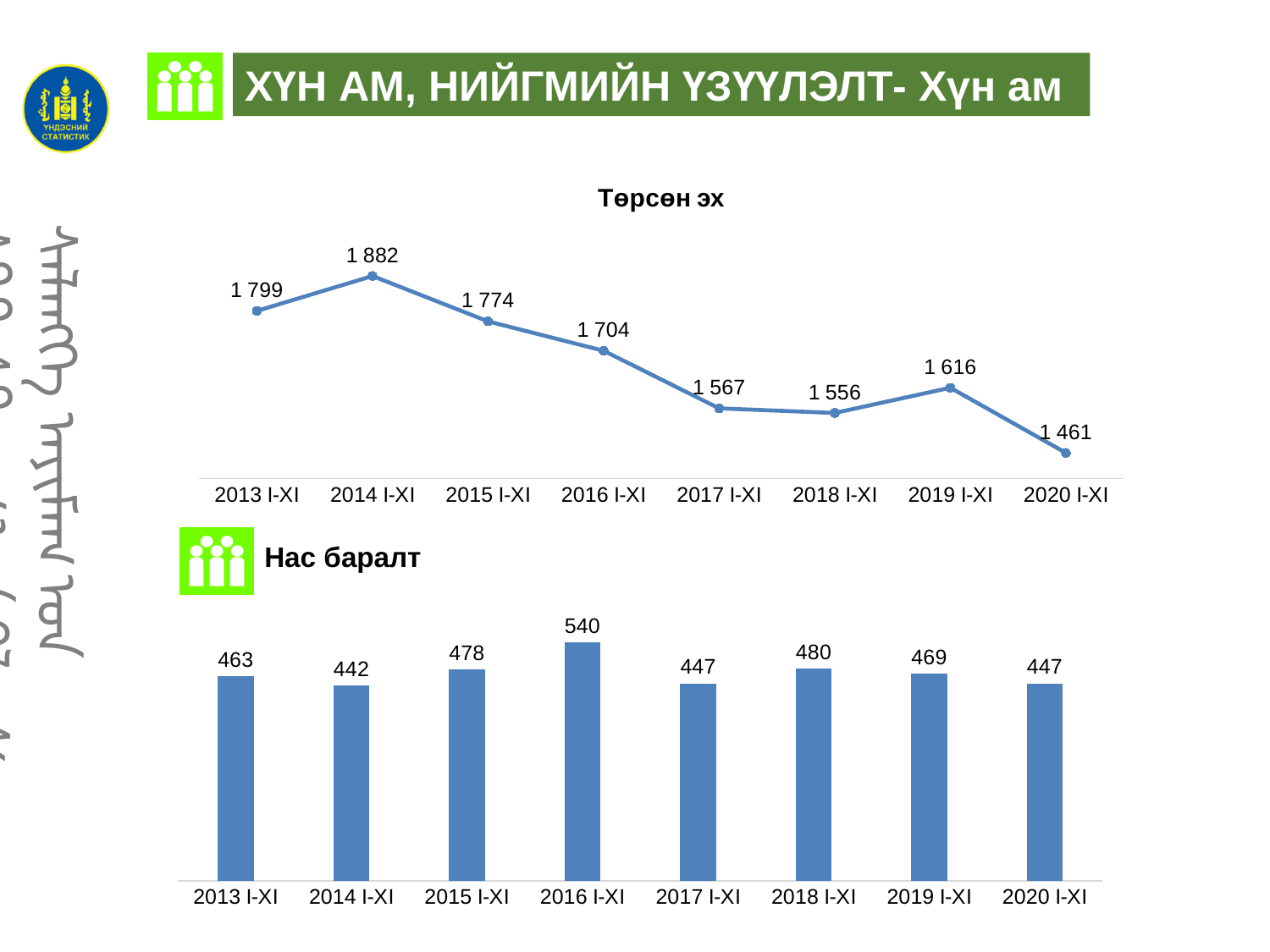
In the 'Төрсөн эх' chart, which period has the lowest value? 2020 I-XI In the 'Нас баралт' chart, what is the difference between the values for 2016 I-XI and 2015 I-XI? 62 In the 'Төрсөн эх' chart, what kind of chart is shown? line chart In the 'Төрсөн эх' chart, is the value for 2019 I-XI larger or smaller than the value for 2018 I-XI? larger In the 'Нас баралт' chart, which period has the lowest value? 2014 I-XI In the 'Нас баралт' chart, how many bars are there? 8 In the 'Нас баралт' chart, what kind of chart is shown? bar chart In the 'Төрсөн эх' chart, what is the value for 2014 I-XI? 1 882 In the 'Төрсөн эх' chart, which period has the highest value? 2014 I-XI In the 'Төрсөн эх' chart, what is the difference between the values for 2013 I-XI and 2020 I-XI? 338 In the 'Төрсөн эх' chart, how many data points are plotted? 8 In the 'Нас баралт' chart, what is the value for 2016 I-XI? 540